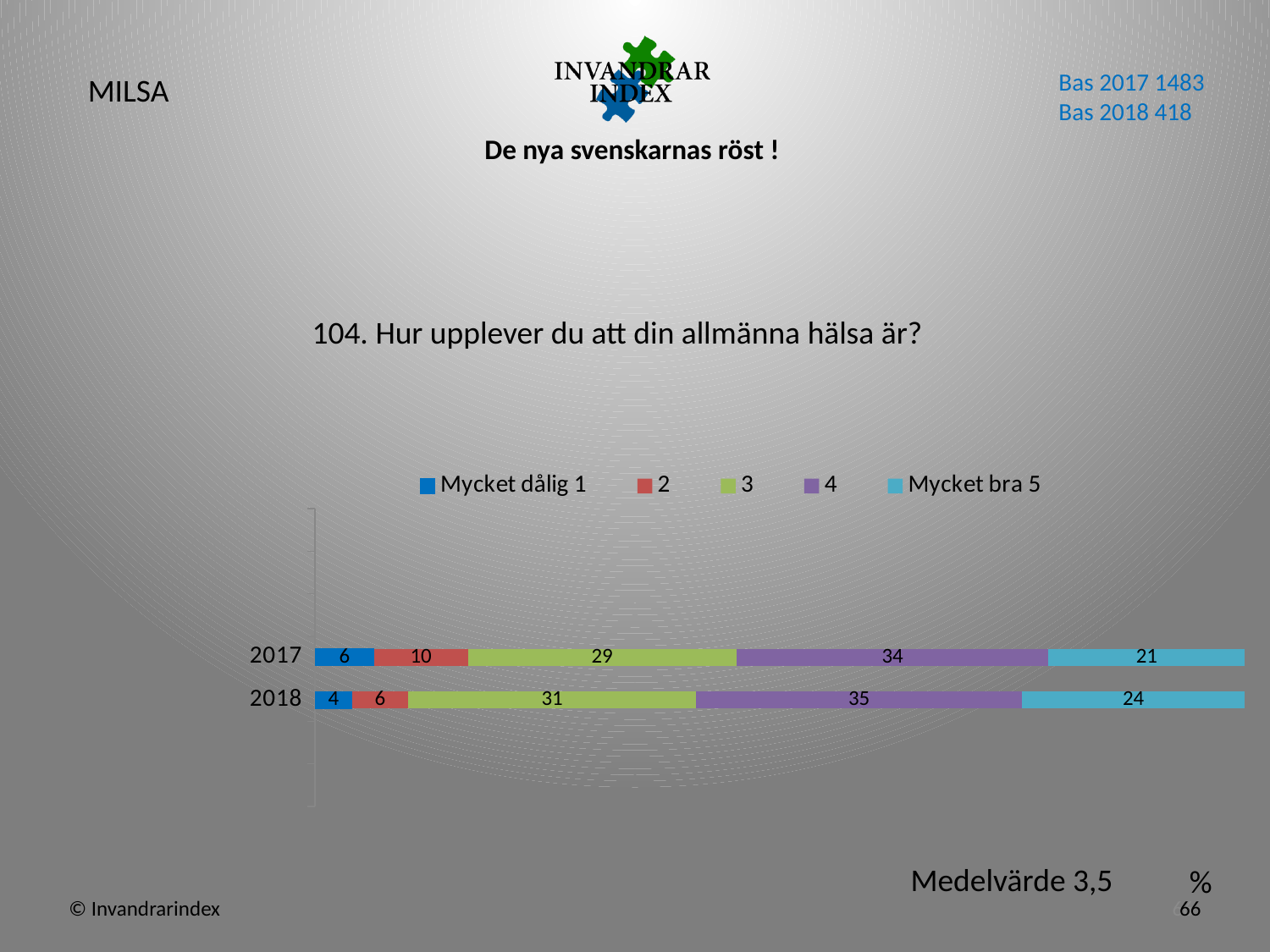
Which series has the lowest value in 2017? Mycket dålig 1 How many categories (years) are shown on the chart? 2 What is the value for 'Mycket bra 5' in 2018? 24 What is the value for '2' in 2017? 10 Which is larger, the value for '2' in 2017 or in 2018? 2017 What kind of chart is shown on the slide? Stacked bar chart What is the value for 'Mycket dålig 1' in 2018? 4 Which series has the highest value in 2018? 4 How many series does the legend list? 5 What is the difference between the 'Mycket bra 5' values for 2018 and 2017? 3 What is the total of the stacked bar for 2017? 100 What is the value for '3' in 2017? 29